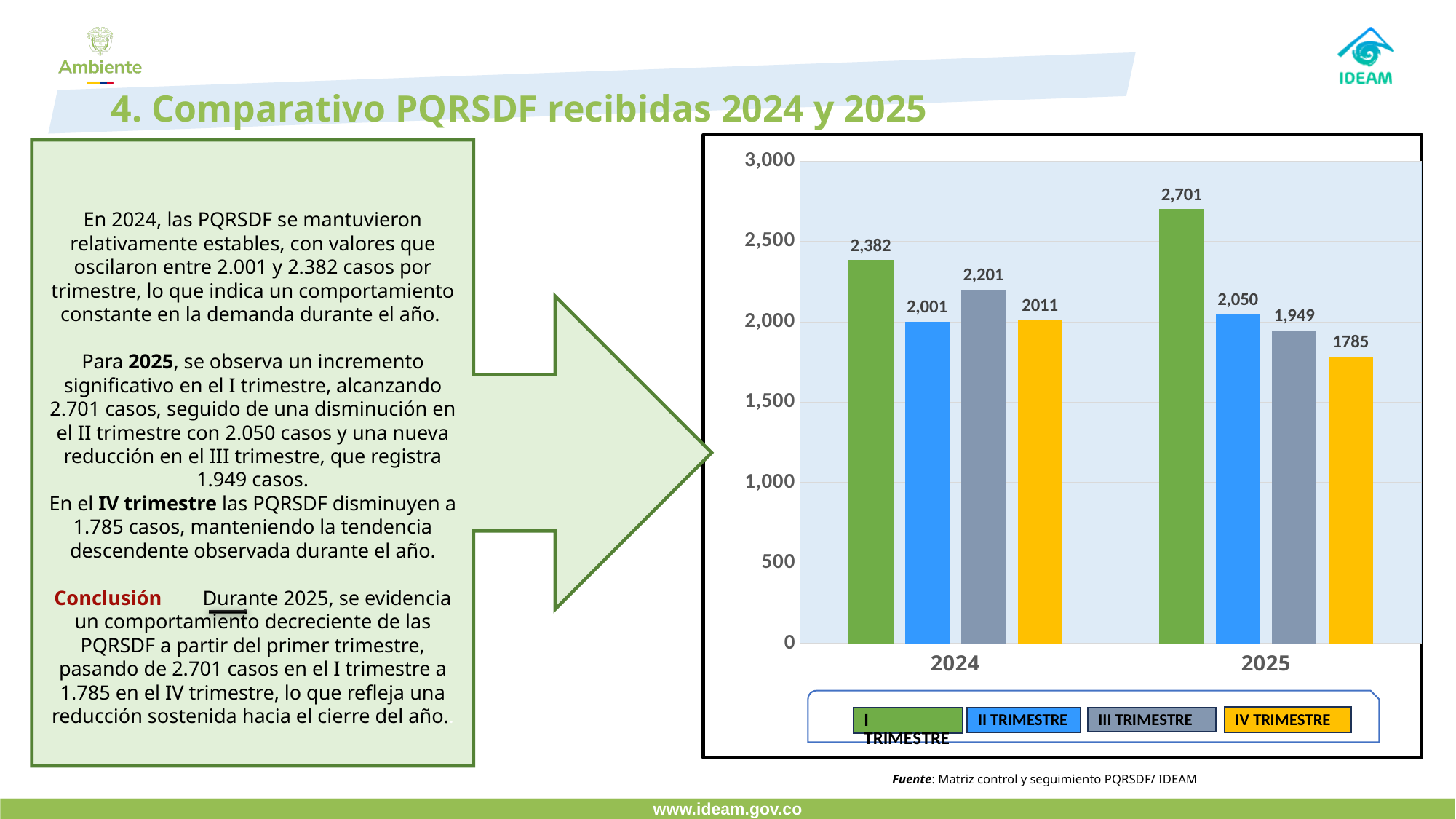
What is the value for III TRIMESTRE in 2025? 1,949 What colour are the IV TRIMESTRE bars? Yellow What is the difference between the I TRIMESTRE values for 2025 and 2024? 319 What is the value for II TRIMESTRE in 2024? 2,001 Which series has the lowest value in 2025? IV TRIMESTRE Which is larger, the III TRIMESTRE value in 2024 or the III TRIMESTRE value in 2025? 2024 How many series does the legend list? 4 Which series has the highest value in 2025? I TRIMESTRE What kind of chart is shown on the slide? Bar chart Is the value for I TRIMESTRE in 2025 greater or less than 2,500? greater What is the value for IV TRIMESTRE in 2025? 1785 What is the value for I TRIMESTRE in 2024? 2,382